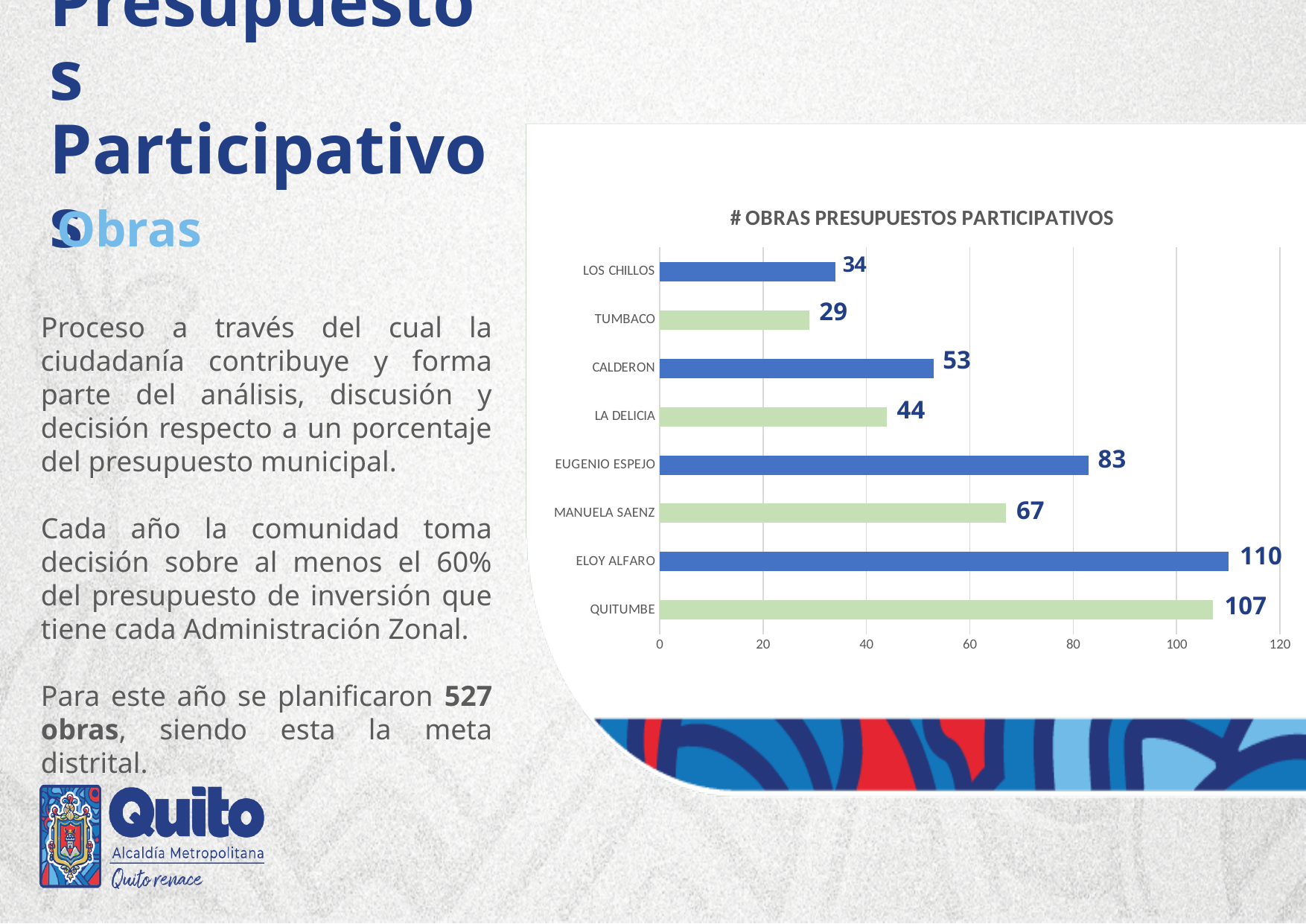
Is the value for LOS CHILLOS greater or less than 40? less What is the value for EUGENIO ESPEJO? 83 What is the value for ELOY ALFARO? 110 Which category has the highest value? ELOY ALFARO What kind of chart is shown on the slide? bar chart Which is larger, the value for MANUELA SAENZ or the value for CALDERON? MANUELA SAENZ What is the title of the chart? # OBRAS PRESUPUESTOS PARTICIPATIVOS Which category has the lowest value? TUMBACO What is the difference between the values for ELOY ALFARO and QUITUMBE? 3 How many categories are shown in the chart? 8 What is the difference between the values for CALDERON and LA DELICIA? 9 What is the value for TUMBACO? 29